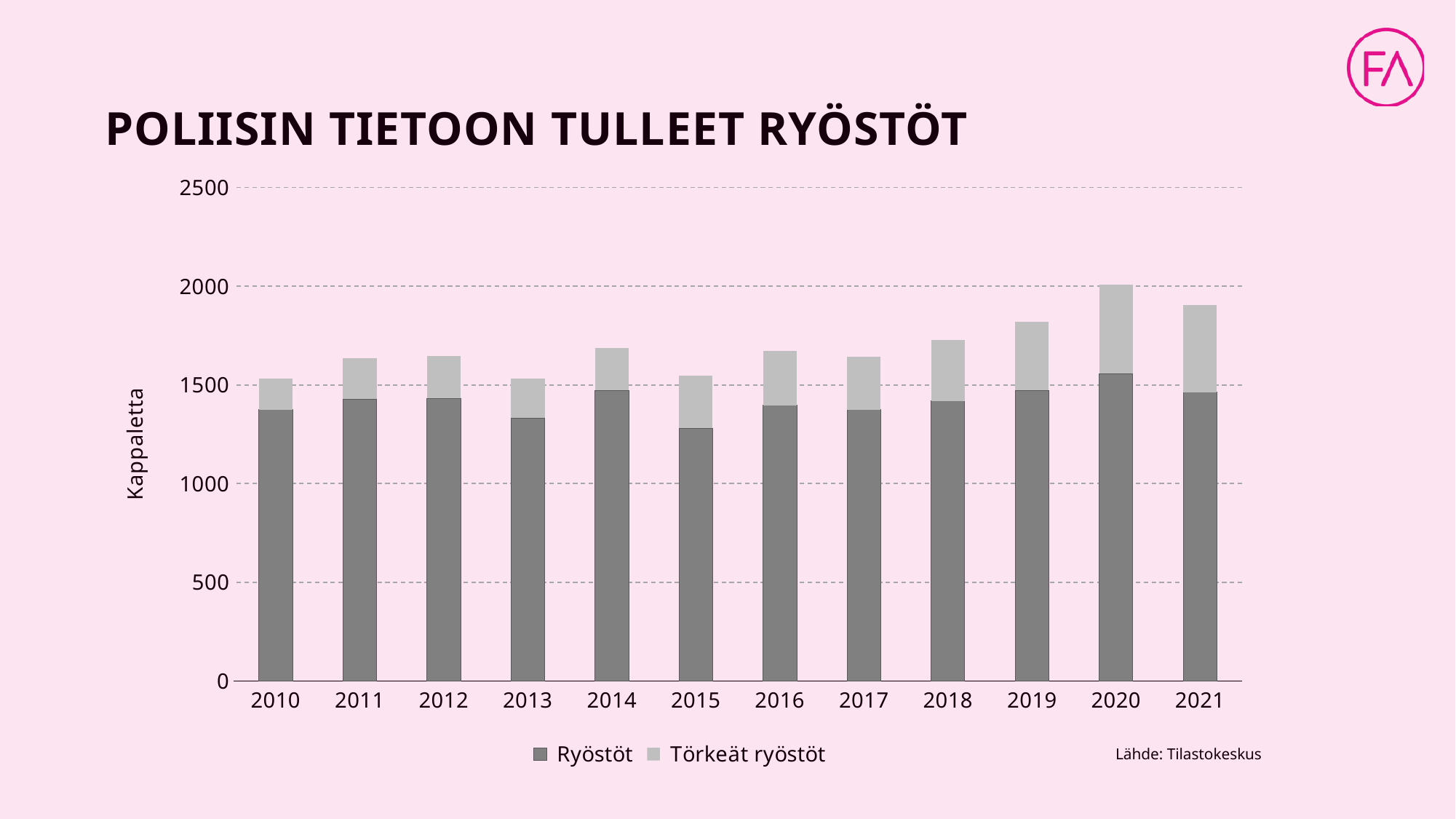
What is the title of the chart? POLIISIN TIETOON TULLEET RYÖSTÖT Which is larger, the total bar for 2020 or the total bar for 2010? 2020 Is the Ryöstöt value for 2020 greater or less than 1500? greater Which year has the tallest Ryöstöt (dark grey) segment? 2020 Which year has the highest total bar in the chart? 2020 Which is larger, the Ryöstöt value for 2014 or the Ryöstöt value for 2015? 2014 Is the total bar for 2019 greater or less than 2000? less Is the Ryöstöt value for 2015 greater or less than 1500? less How many years are shown on the x axis of the chart? 12 What kind of chart is shown on the slide? Stacked bar chart How many series does the chart's legend list? 2